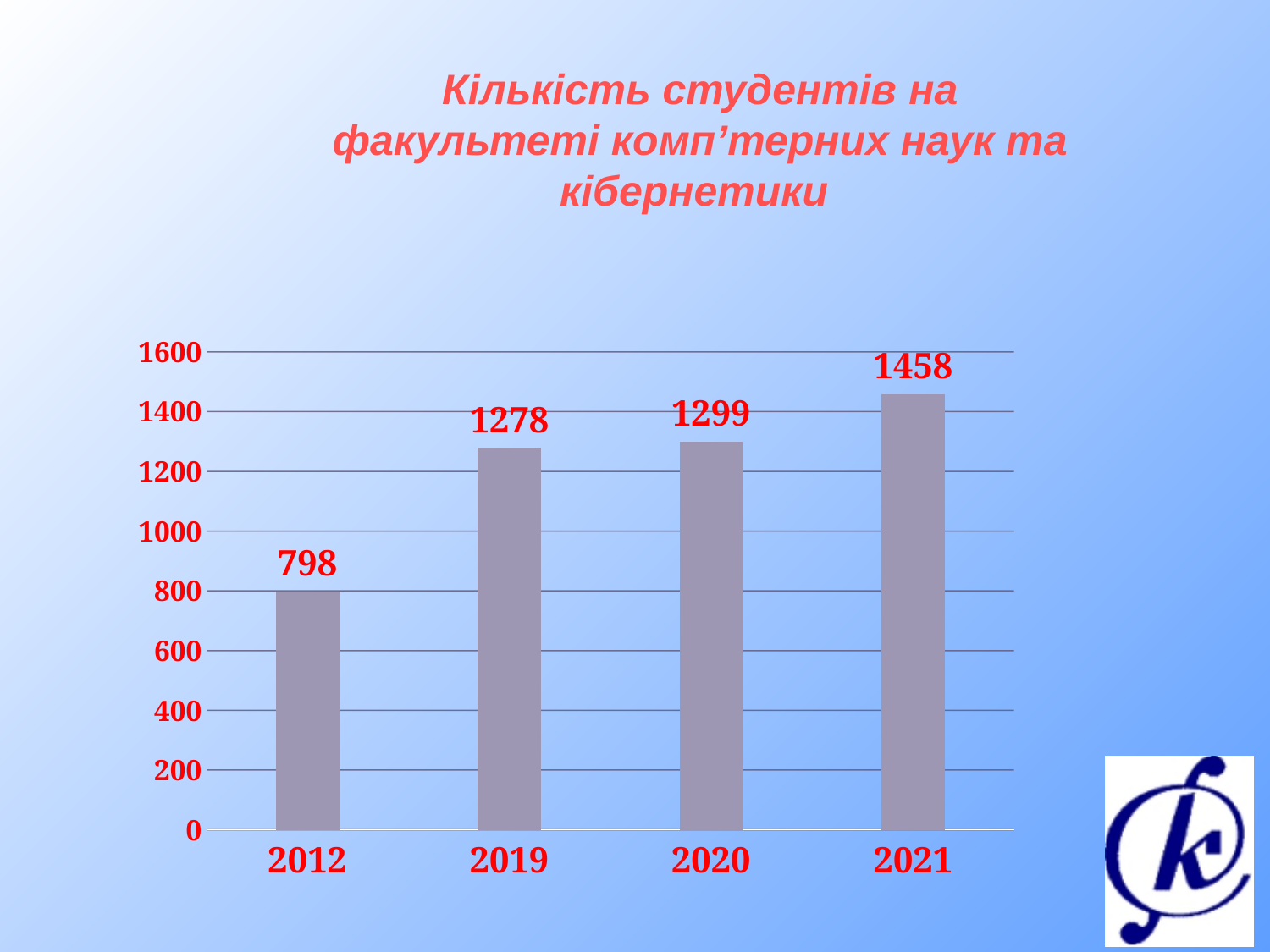
What is the value for 2020? 1299 Which is larger, the value for 2019 or the value for 2021? 2021 What is the value for 2021? 1458 What is the value for 2012? 798 What is the difference between the values for 2020 and 2019? 21 What is the difference between the values for 2021 and 2012? 660 What is the value for 2019? 1278 Which year has the highest value? 2021 How many years are shown on the x axis? 4 What kind of chart is shown on the slide? bar chart Is the value for 2012 greater or less than 1000? less Which year has the lowest value? 2012